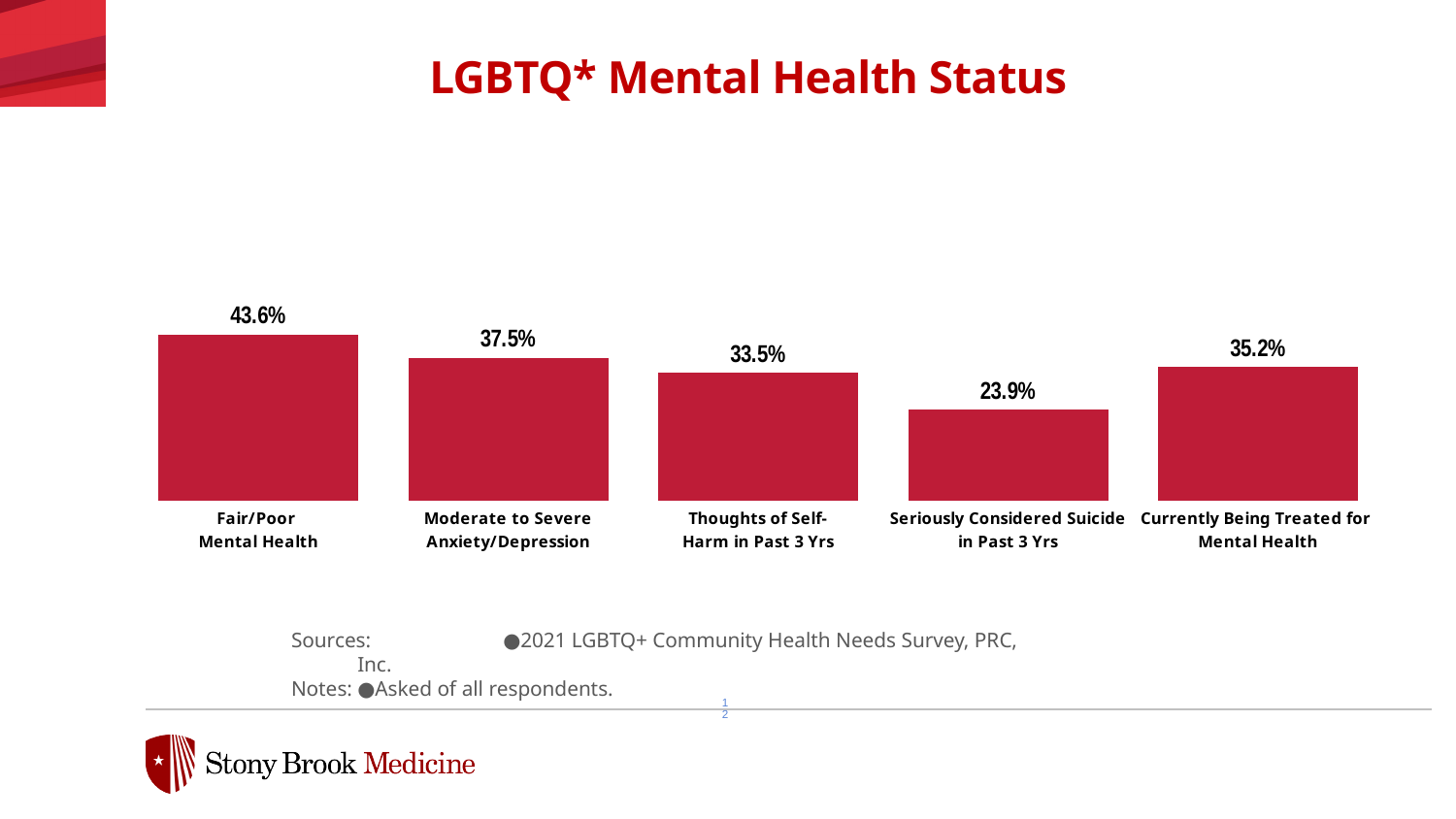
What percentage are Currently Being Treated for Mental Health? 35.2% What is the difference between Fair/Poor Mental Health and Seriously Considered Suicide in Past 3 Yrs? 19.7% What percentage of respondents reported Fair/Poor Mental Health? 43.6% What is the value for Seriously Considered Suicide in Past 3 Yrs? 23.9% How many categories are shown in the chart? 5 What is the title of the chart? LGBTQ* Mental Health Status What percentage reported Thoughts of Self-Harm in Past 3 Yrs? 33.5% What is the value for Moderate to Severe Anxiety/Depression? 37.5% Which category has the highest value? Fair/Poor Mental Health What type of chart is shown on the slide? Bar chart Which category has the lowest value? Seriously Considered Suicide in Past 3 Yrs Which is larger: Moderate to Severe Anxiety/Depression or Currently Being Treated for Mental Health? Moderate to Severe Anxiety/Depression